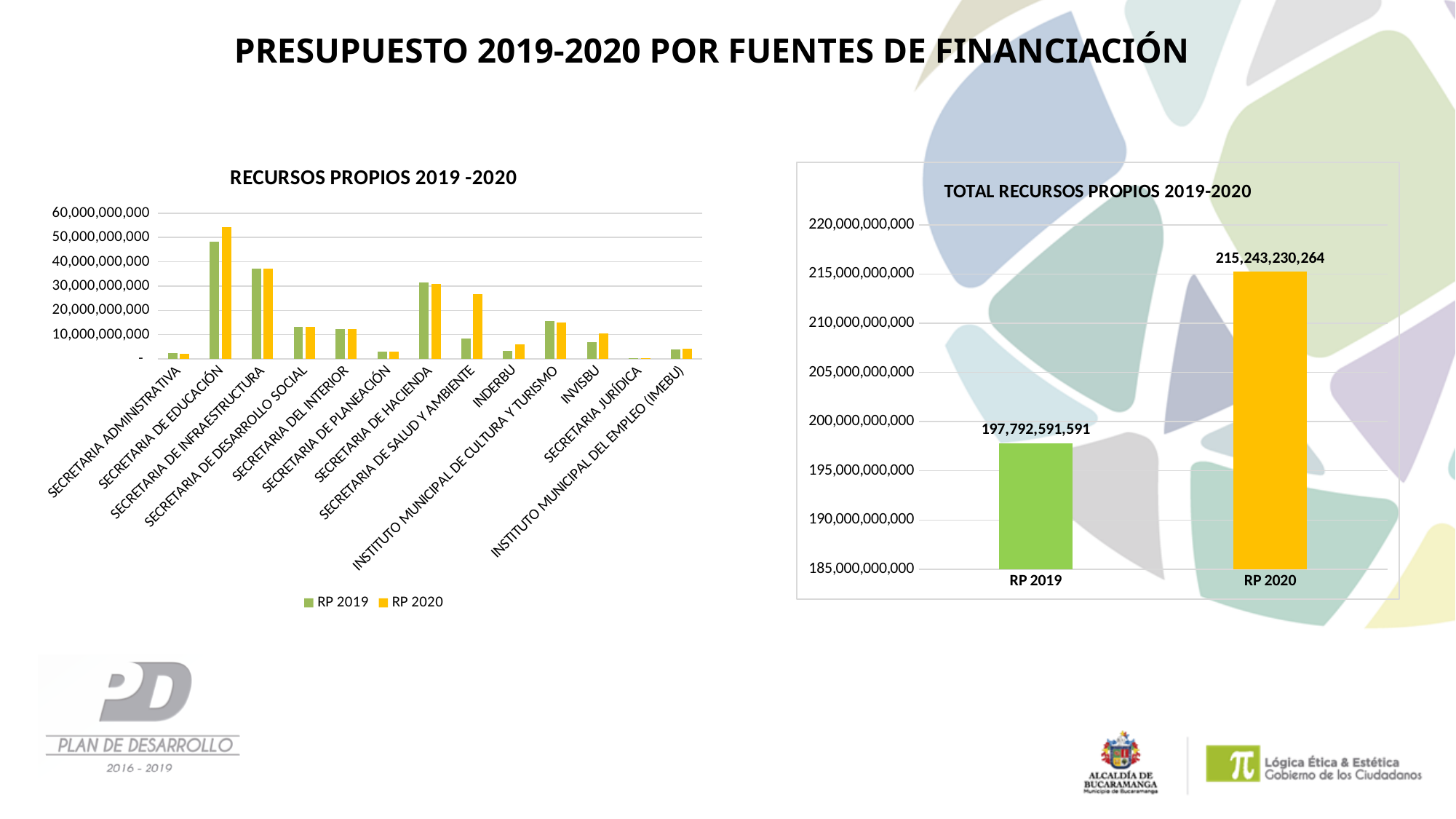
In the 'RECURSOS PROPIOS 2019 -2020' chart, is the RP 2020 value for SECRETARIA DE EDUCACIÓN greater or less than 50,000,000,000? greater In the 'TOTAL RECURSOS PROPIOS 2019-2020' chart, what is the difference between the RP 2020 and RP 2019 values? 17,450,638,673 In the 'TOTAL RECURSOS PROPIOS 2019-2020' chart, what is the value for RP 2020? 215,243,230,264 In the 'TOTAL RECURSOS PROPIOS 2019-2020' chart, what is the value for RP 2019? 197,792,591,591 In the 'TOTAL RECURSOS PROPIOS 2019-2020' chart, which bar is higher, RP 2019 or RP 2020? RP 2020 In the 'RECURSOS PROPIOS 2019 -2020' chart, how many categories are shown on the x axis? 13 In the 'RECURSOS PROPIOS 2019 -2020' chart, which category has the highest RP 2020 value? SECRETARIA DE EDUCACIÓN In the 'RECURSOS PROPIOS 2019 -2020' chart, which is larger for SECRETARIA DE SALUD Y AMBIENTE, RP 2019 or RP 2020? RP 2020 In the 'RECURSOS PROPIOS 2019 -2020' chart, which category has the lowest RP 2019 value? SECRETARIA JURÍDICA In the 'RECURSOS PROPIOS 2019 -2020' chart, how many series does the legend list? 2 What kind of chart is 'TOTAL RECURSOS PROPIOS 2019-2020'? Bar chart In the 'RECURSOS PROPIOS 2019 -2020' chart, is the RP 2020 value for SECRETARIA DE SALUD Y AMBIENTE greater or less than 30,000,000,000? less